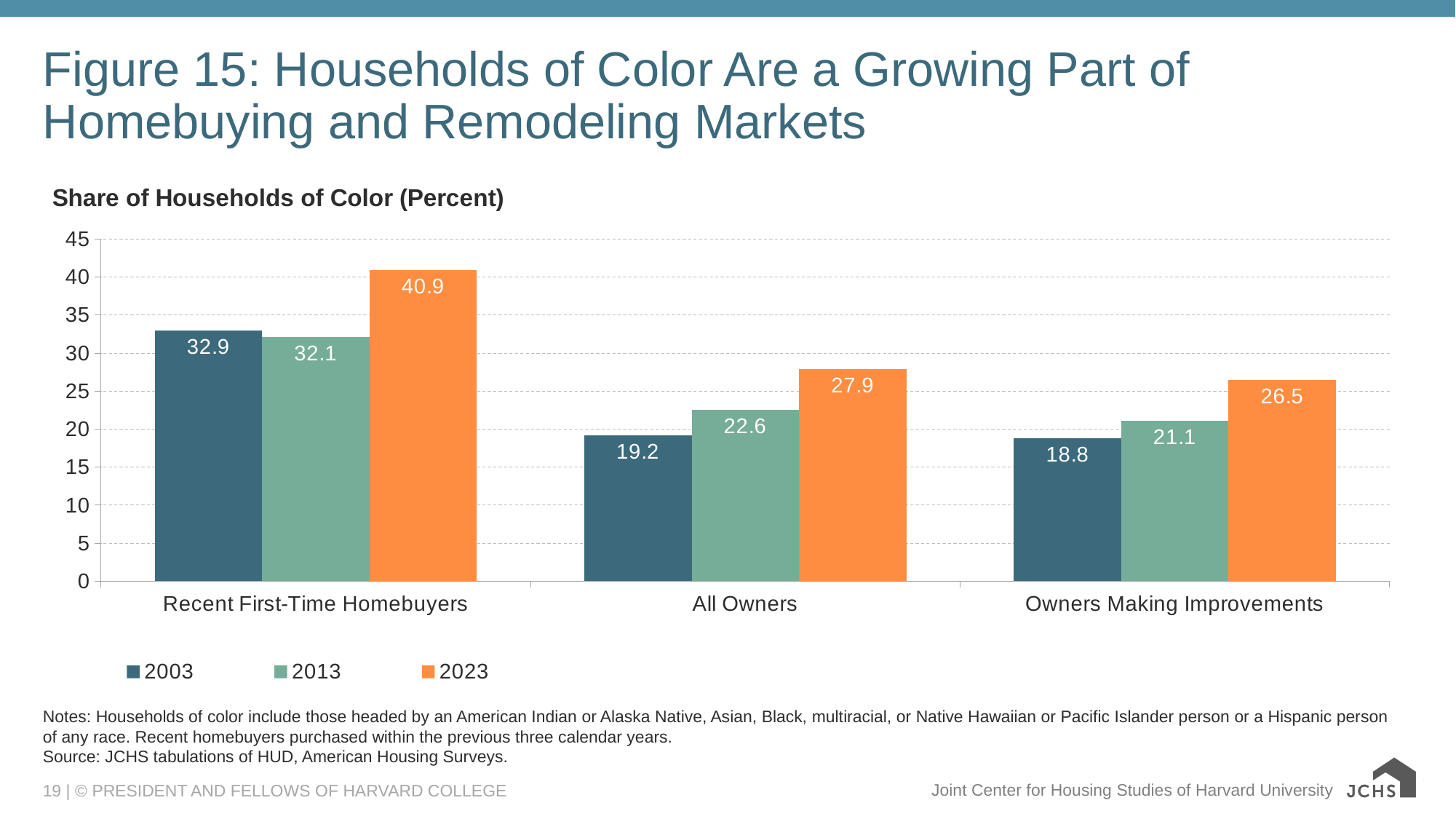
What is the value for All Owners in 2003? 19.2 What is the value for Owners Making Improvements in 2013? 21.1 Which category has the lowest value in 2003? Owners Making Improvements What is the difference between the 2023 and 2003 values for All Owners? 8.7 What is the difference between the 2023 and 2013 values for Recent First-Time Homebuyers? 8.8 What is the value for Recent First-Time Homebuyers in 2023? 40.9 Which category has the highest value in 2023? Recent First-Time Homebuyers Which is larger for Owners Making Improvements: the 2013 value or the 2023 value? 2023 How many categories are shown on the x axis? 3 How many series does the legend list? 3 What kind of chart is shown on the slide? Bar chart What is the chart's subtitle above the plot area? Share of Households of Color (Percent)